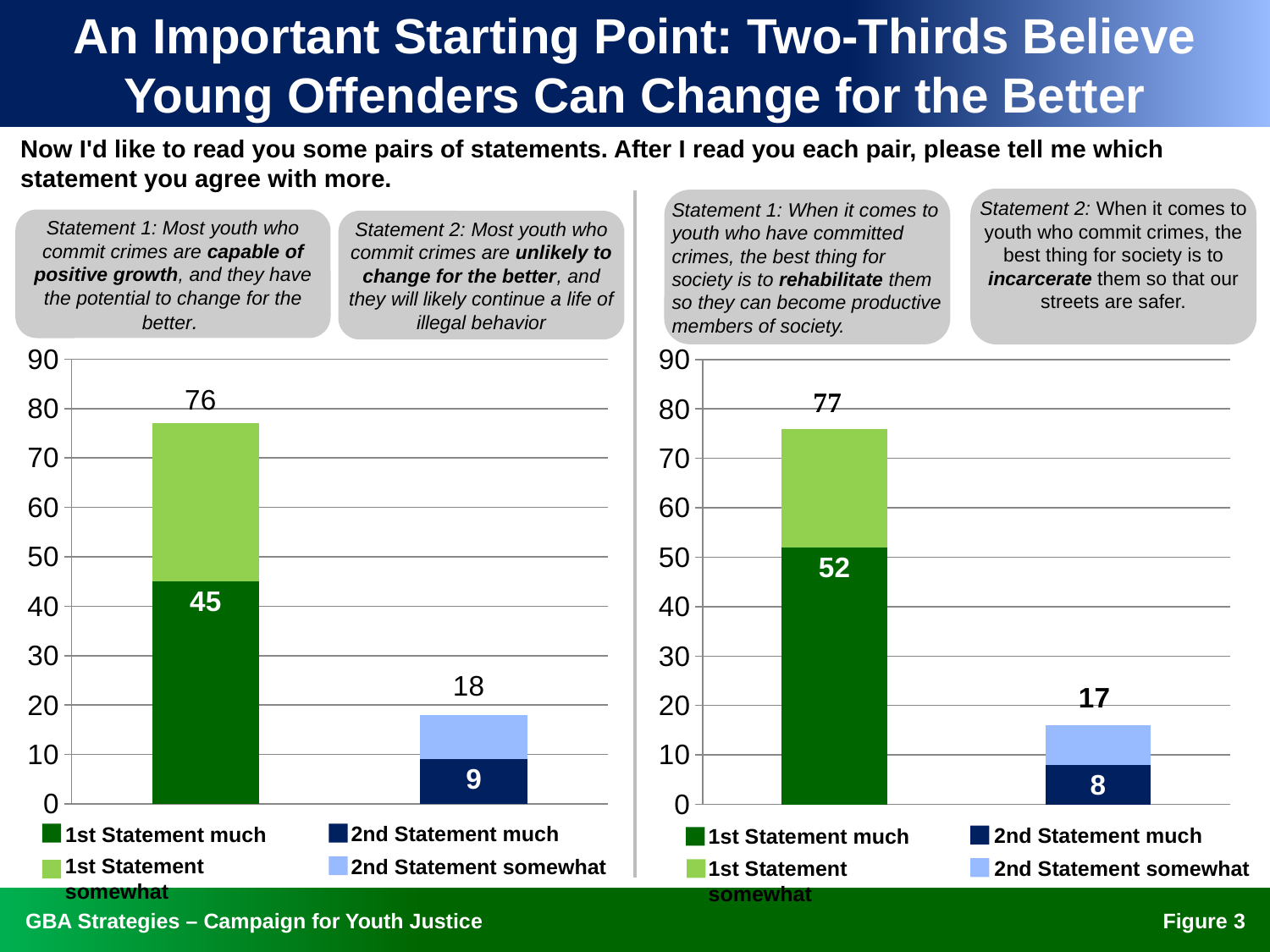
On the right chart, what is the total value shown above the 1st Statement bar? 77 On the left chart, what is the value of the '2nd Statement much' segment? 9 What kind of chart is the left chart? Stacked bar chart How many bars are plotted on the right chart? 2 On the left chart, what is the total value shown above the 1st Statement bar? 76 On the right chart, what is the value of the '1st Statement much' segment? 52 On the right chart, what is the total value shown above the 2nd Statement bar? 17 On the right chart, which bar is taller, the 1st Statement bar or the 2nd Statement bar? 1st Statement How many series does the legend of the left chart list? 4 On the right chart, is the '2nd Statement much' value greater or less than 10? less On the left chart, what is the value of the '1st Statement much' segment? 45 On the left chart, what is the difference between the 1st Statement total (76) and the 2nd Statement total (18)? 58